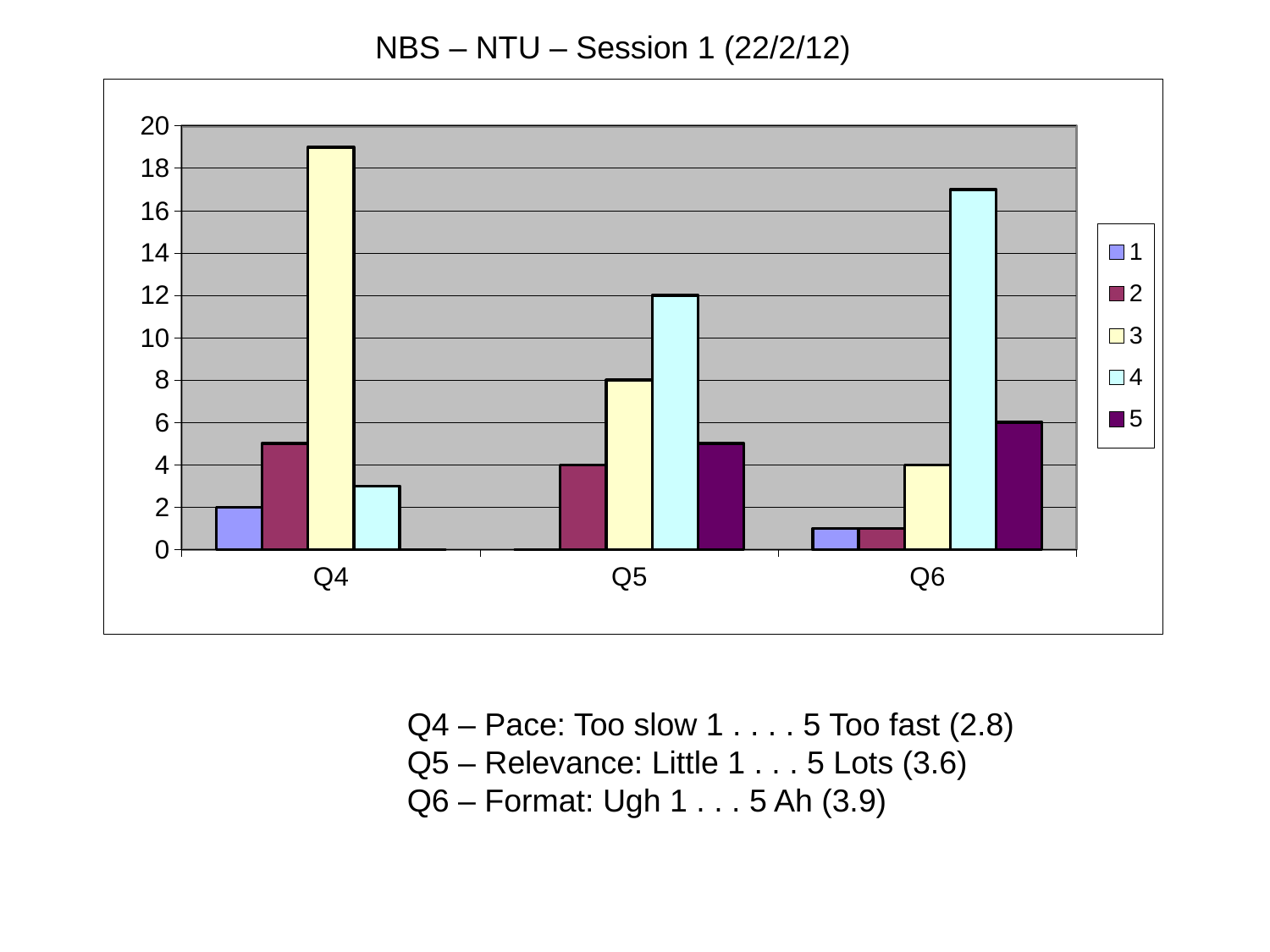
Which series has the highest bar for Q6? 4 What is the difference between series 4 and series 3 for Q5? 4 Which series has the highest bar for Q4? 3 What is the value of series 1 for Q4? 2 Which is larger: series 4 for Q5 or series 4 for Q6? series 4 for Q6 Is the value of series 3 for Q4 greater or less than 18? greater How many categories are shown on the x axis? 3 How many series does the legend list? 5 What is the value of series 5 for Q6? 6 What is the value of series 3 for Q5? 8 What kind of chart is shown on the slide? bar chart What is the value of series 4 for Q5? 12